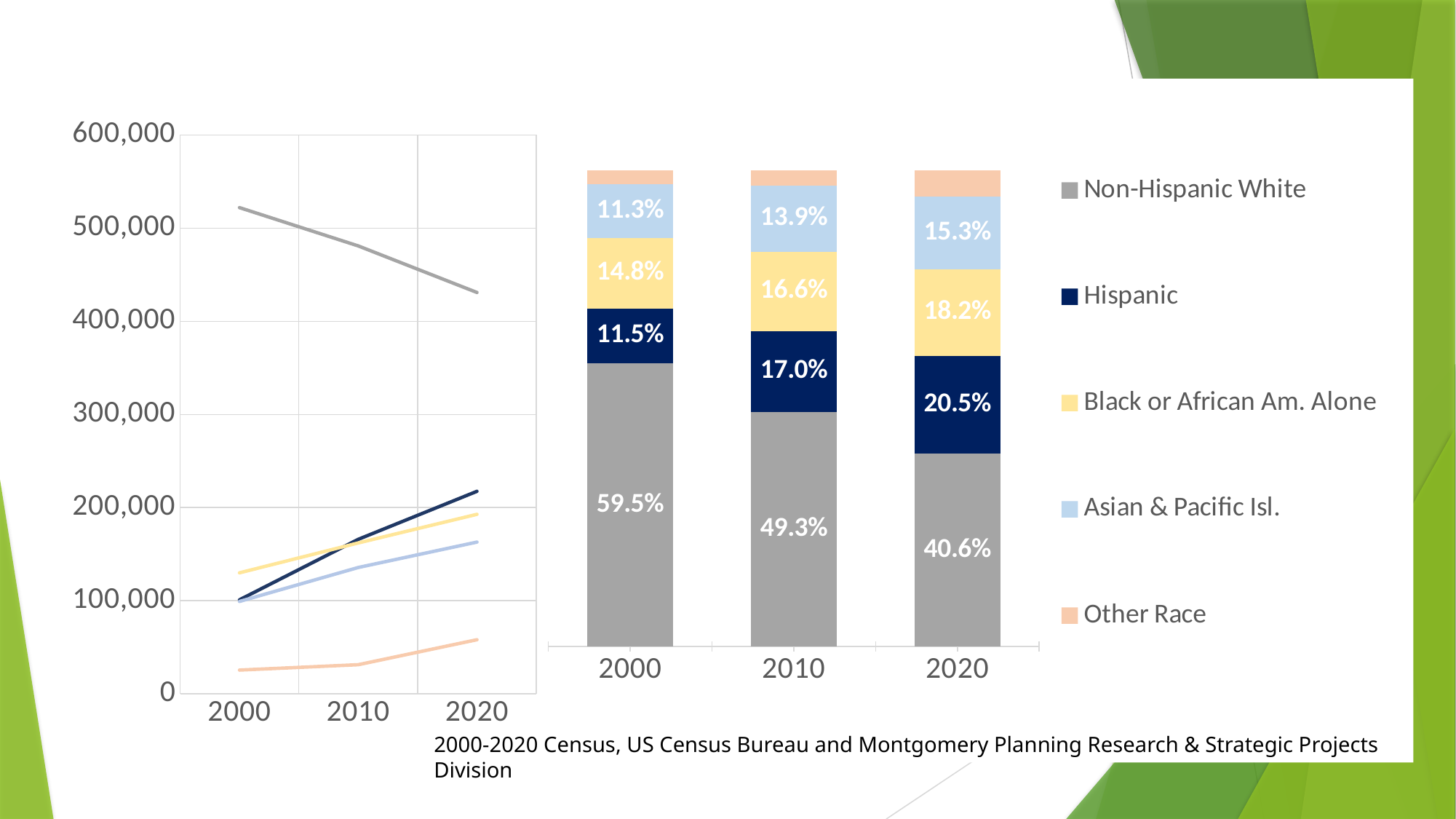
In the stacked bar chart on the right, which is larger in 2010: the Hispanic share or the Black or African Am. Alone share? Hispanic In the stacked bar chart on the right, what is the Hispanic share in 2020? 20.5% In the stacked bar chart on the right, what is the Black or African Am. Alone share in 2020? 18.2% How many series does the legend of the stacked bar chart list? 5 In the stacked bar chart on the right, what is the Asian & Pacific Isl. share in 2010? 13.9% In the stacked bar chart on the right, by how many percentage points did the Non-Hispanic White share fall from 2000 to 2020? 18.9 percentage points What kind of chart is the chart on the right of the slide? Stacked bar chart In the stacked bar chart on the right, does the Hispanic share rise or fall from 2000 to 2020? Rise In the line chart on the left, does the gray line rise or fall from 2000 to 2020? Fall In the stacked bar chart on the right, what is the Non-Hispanic White share in 2000? 59.5% In the line chart on the left, is the value of the gray line in 2000 greater or less than 500,000? greater How many years are shown on the x axis of the stacked bar chart on the right? 3